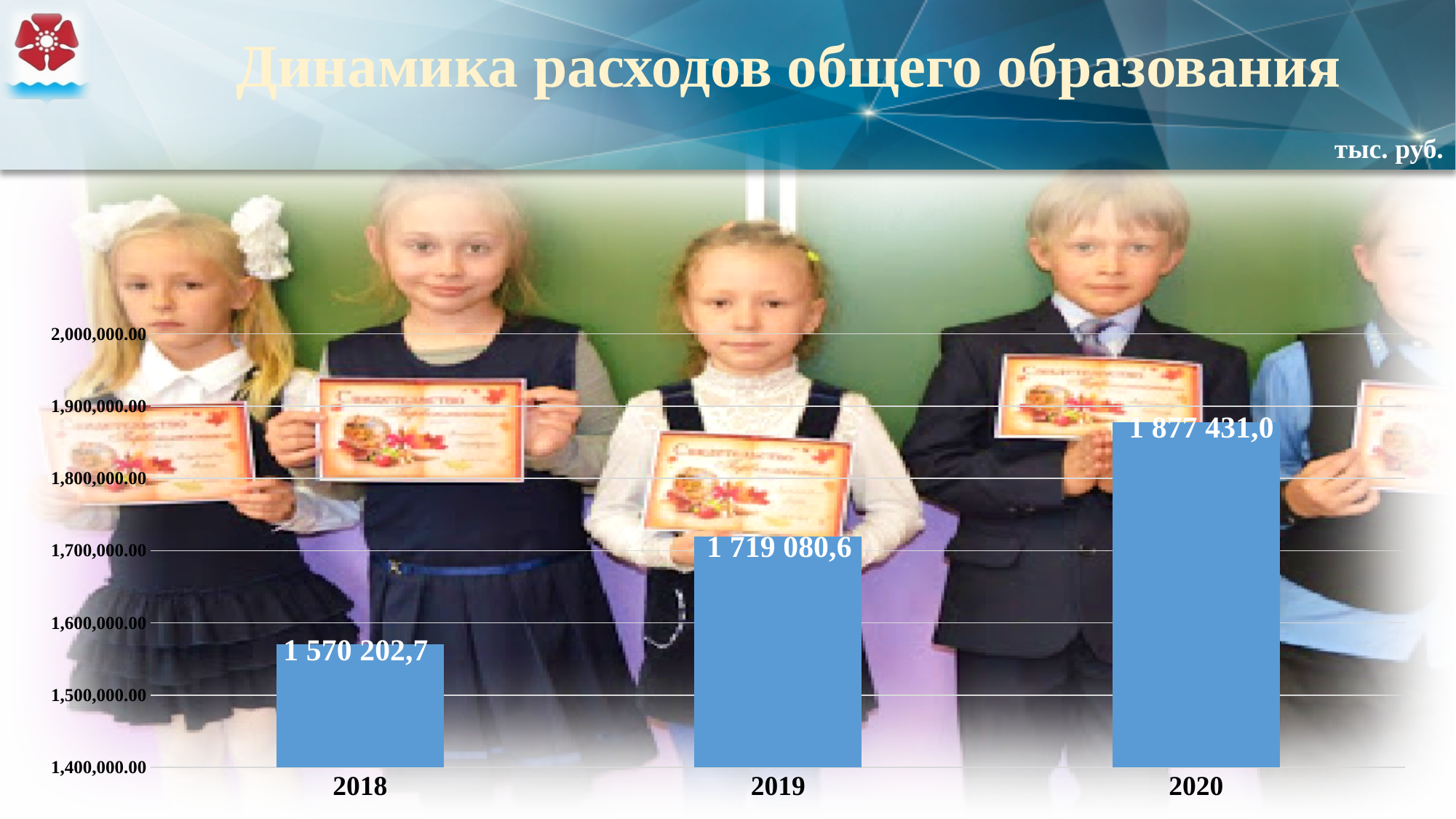
Is the value for 2018 greater or less than 1,600,000.00? less What kind of chart is shown on the slide? bar chart How many years are shown on the chart? 3 What is the value for 2018? 1 570 202,7 Which year has the highest value? 2020 What is the difference between the values for 2019 and 2018? 148 877,9 Which year has the lowest value? 2018 What is the value for 2020? 1 877 431,0 Do the values rise or fall from 2018 to 2020? rise What is the value for 2019? 1 719 080,6 Which is larger, the value for 2019 or the value for 2020? 2020 What is the difference between the values for 2020 and 2019? 158 350,4